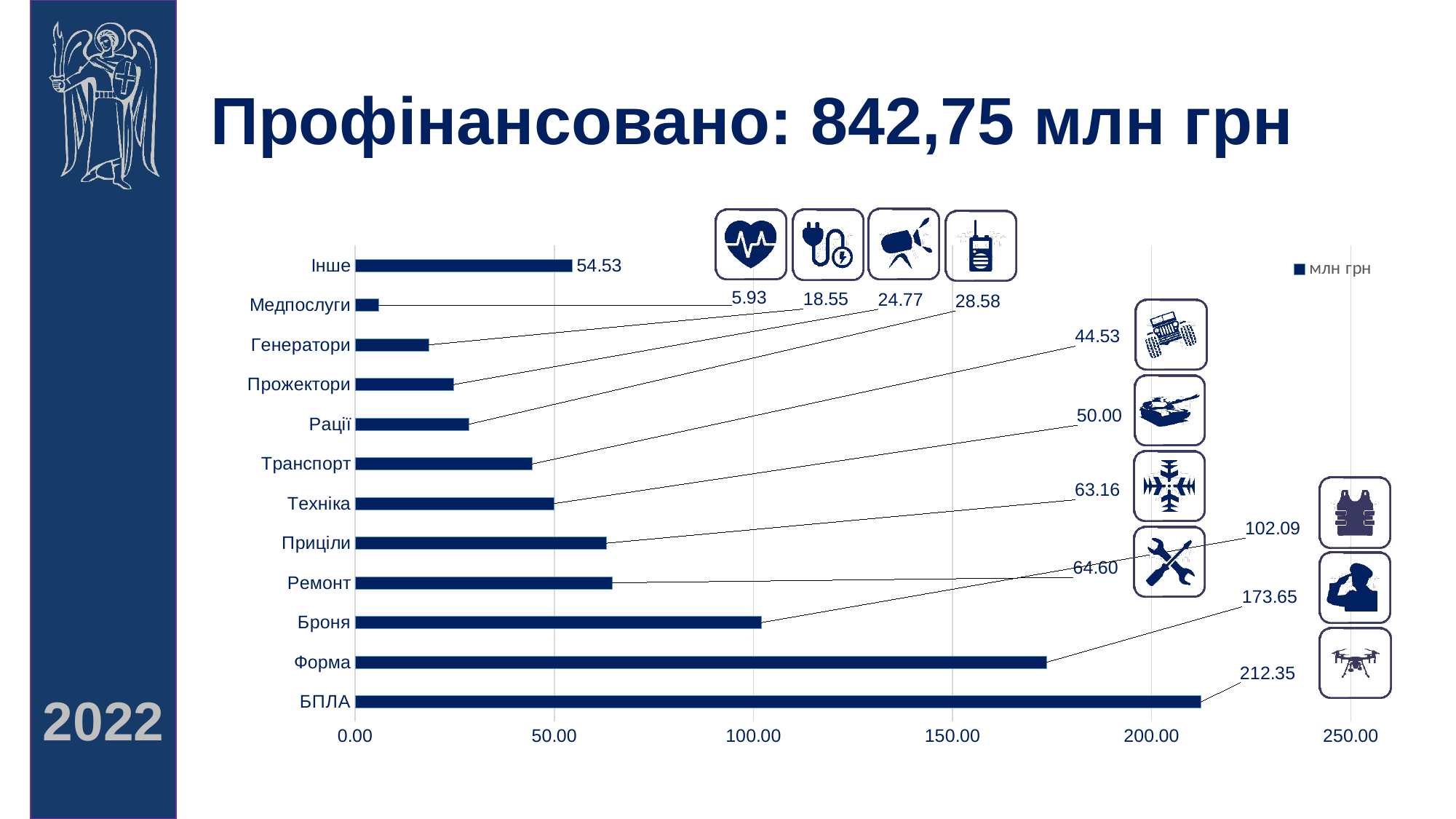
What is the value for БПЛА? 212.35 What type of chart is shown on the slide? bar chart Which is larger, the value for Транспорт or the value for Техніка? Техніка Which category has the highest value? БПЛА What is the value for Броня? 102.09 What is the value for Форма? 173.65 How many categories are shown in the chart? 12 Which category has the lowest value? Медпослуги What is the difference between the values for БПЛА and Форма? 38.70 What series name does the legend show? млн грн Is the value for Броня greater or less than 100.00? greater What is the value for Медпослуги? 5.93